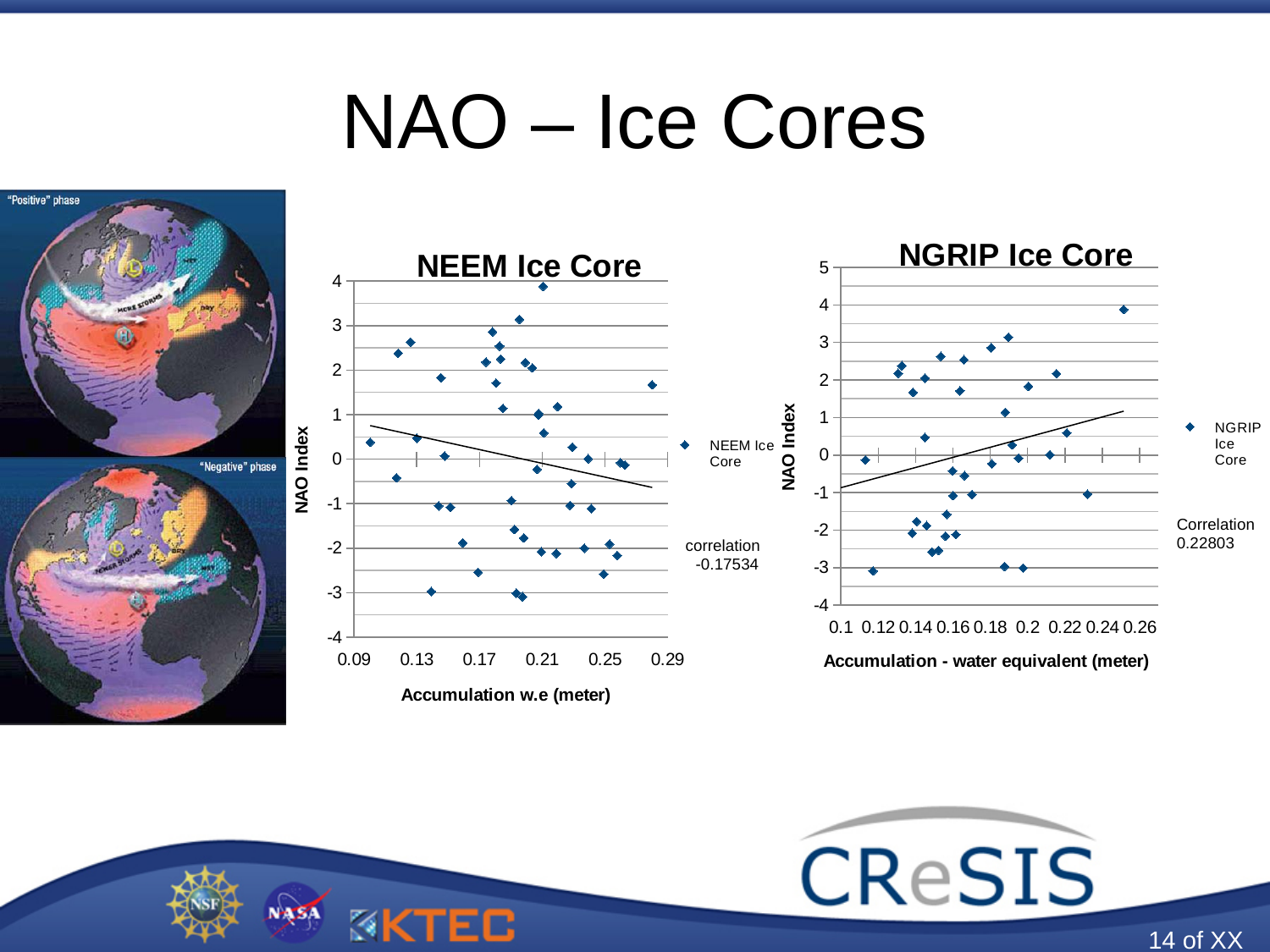
How many series does the legend of the NGRIP Ice Core chart list? 1 In the NEEM Ice Core chart, does the fitted trend line rise or fall as accumulation increases? fall In the NGRIP Ice Core chart, is the highest NAO Index value plotted greater or less than 3? greater How many series does the legend of the NEEM Ice Core chart list? 1 What is the x-axis label of the NGRIP Ice Core chart? Accumulation - water equivalent (meter) What kind of chart is the NEEM Ice Core chart? scatter chart In the NEEM Ice Core chart, is the highest NAO Index value plotted greater or less than 3? greater What kind of chart is the NGRIP Ice Core chart? scatter chart What correlation value is shown next to the NEEM Ice Core chart? -0.17534 In the NGRIP Ice Core chart, does the fitted trend line rise or fall as accumulation increases? rise In the NEEM Ice Core chart, is the lowest NAO Index value plotted greater or less than -2? less